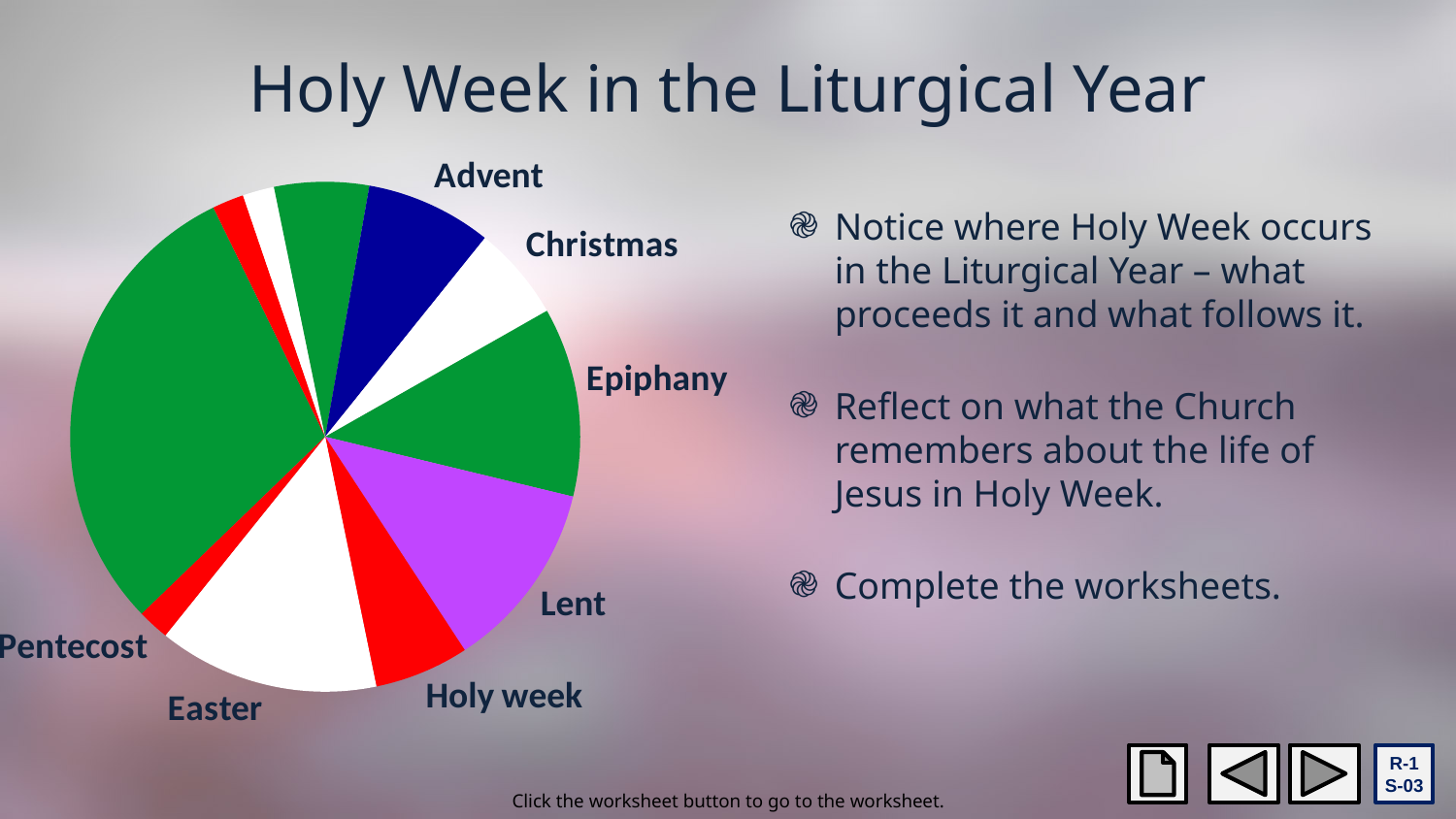
Which slice is larger in the pie chart, Lent or Holy week? Lent Which slice is larger in the pie chart, Epiphany or Holy week? Epiphany Which slice is larger in the pie chart, Easter or Advent? Easter What kind of chart is shown on the slide? Pie chart Which labelled slice comes immediately after Lent going clockwise around the pie chart? Holy week How many labelled seasons are shown around the pie chart? 7 What colour is the Lent slice in the pie chart? Purple What is the title of the slide containing the pie chart? Holy Week in the Liturgical Year